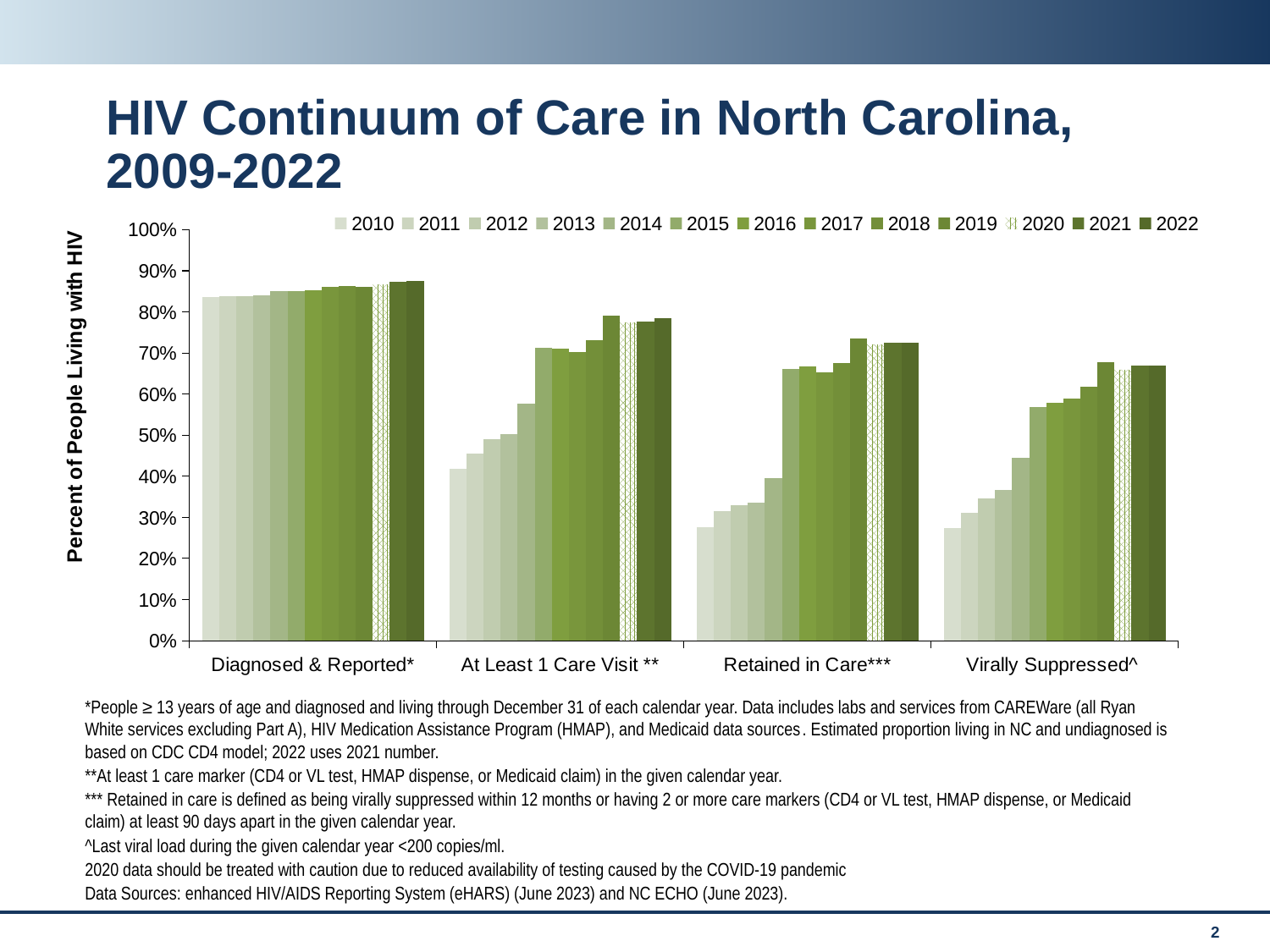
Which category has the lowest value in 2022? Virally Suppressed Which category has the highest values across all years? Diagnosed & Reported Is the value for Virally Suppressed in 2022 greater or less than 60%? greater How many categories are shown along the x axis of the chart? 4 Is the value for At Least 1 Care Visit in 2010 greater or less than 50%? less Is the value for Retained in Care in 2010 greater or less than 30%? less What is the title of the chart on the slide? HIV Continuum of Care in North Carolina, 2009-2022 Which is larger in 2010: the value for At Least 1 Care Visit or the value for Retained in Care? At Least 1 Care Visit How many series (years) does the legend list? 13 Which year in the legend is shown with a hatched pattern rather than a solid fill? 2020 What kind of chart is shown on the slide? Bar chart